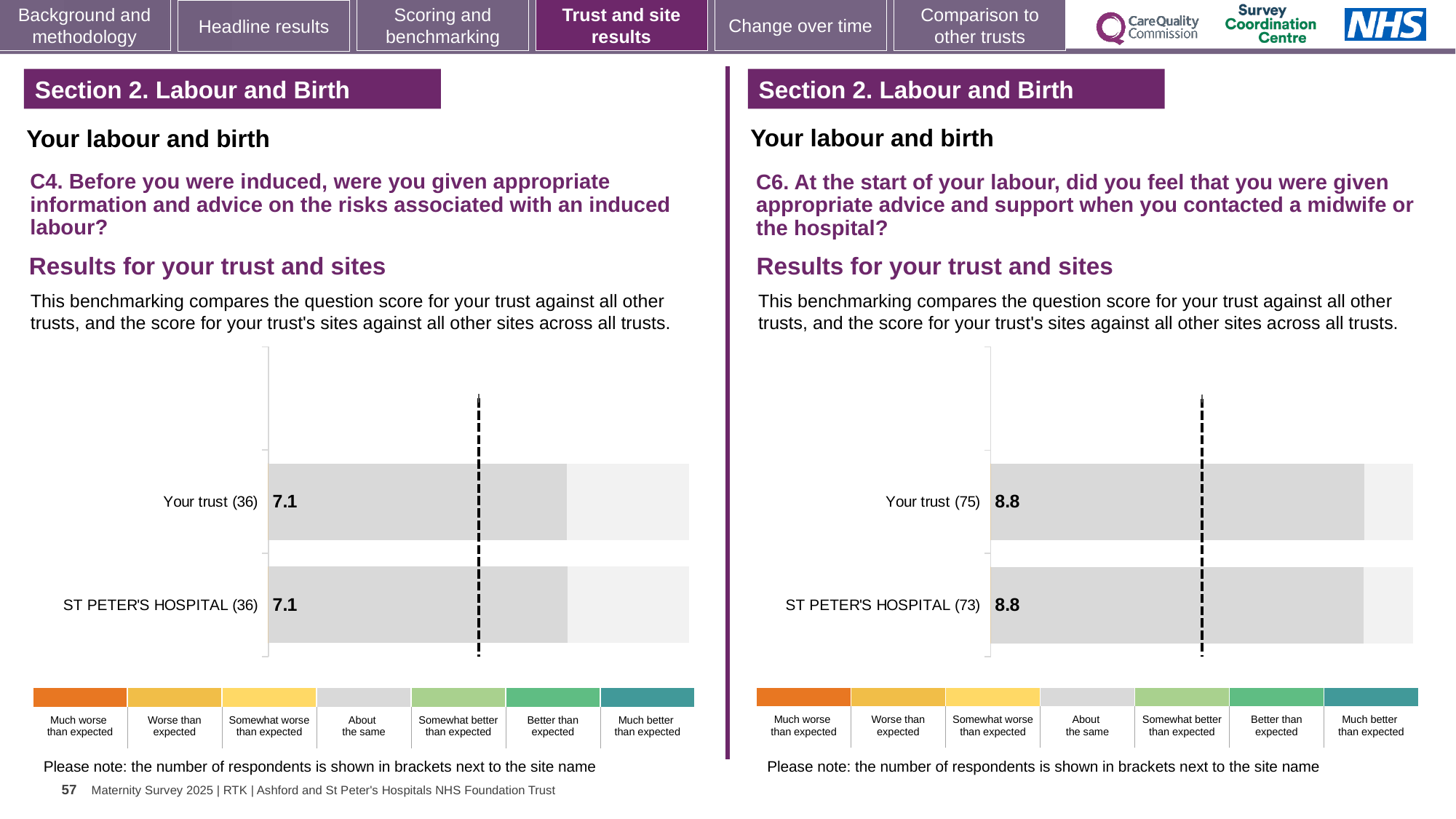
In the right chart (C6), what is the score for Your trust? 8.8 In the left chart (C4), how many respondents are shown in brackets next to Your trust? 36 In the left chart (C4), what is the score for ST PETER'S HOSPITAL? 7.1 How many bars are plotted in the right chart (C6)? 2 What kind of chart is used in the left chart (C4)? Bar chart In the left chart (C4), what is the score for Your trust? 7.1 In the left chart (C4), what is the difference between the score for Your trust and the score for ST PETER'S HOSPITAL? 0 In the right chart (C6), how many respondents are shown in brackets next to ST PETER'S HOSPITAL? 73 In the right chart (C6), what is the score for ST PETER'S HOSPITAL? 8.8 How many bars are plotted in the left chart (C4)? 2 In the right chart (C6), what is the difference between the score for Your trust and the score for ST PETER'S HOSPITAL? 0